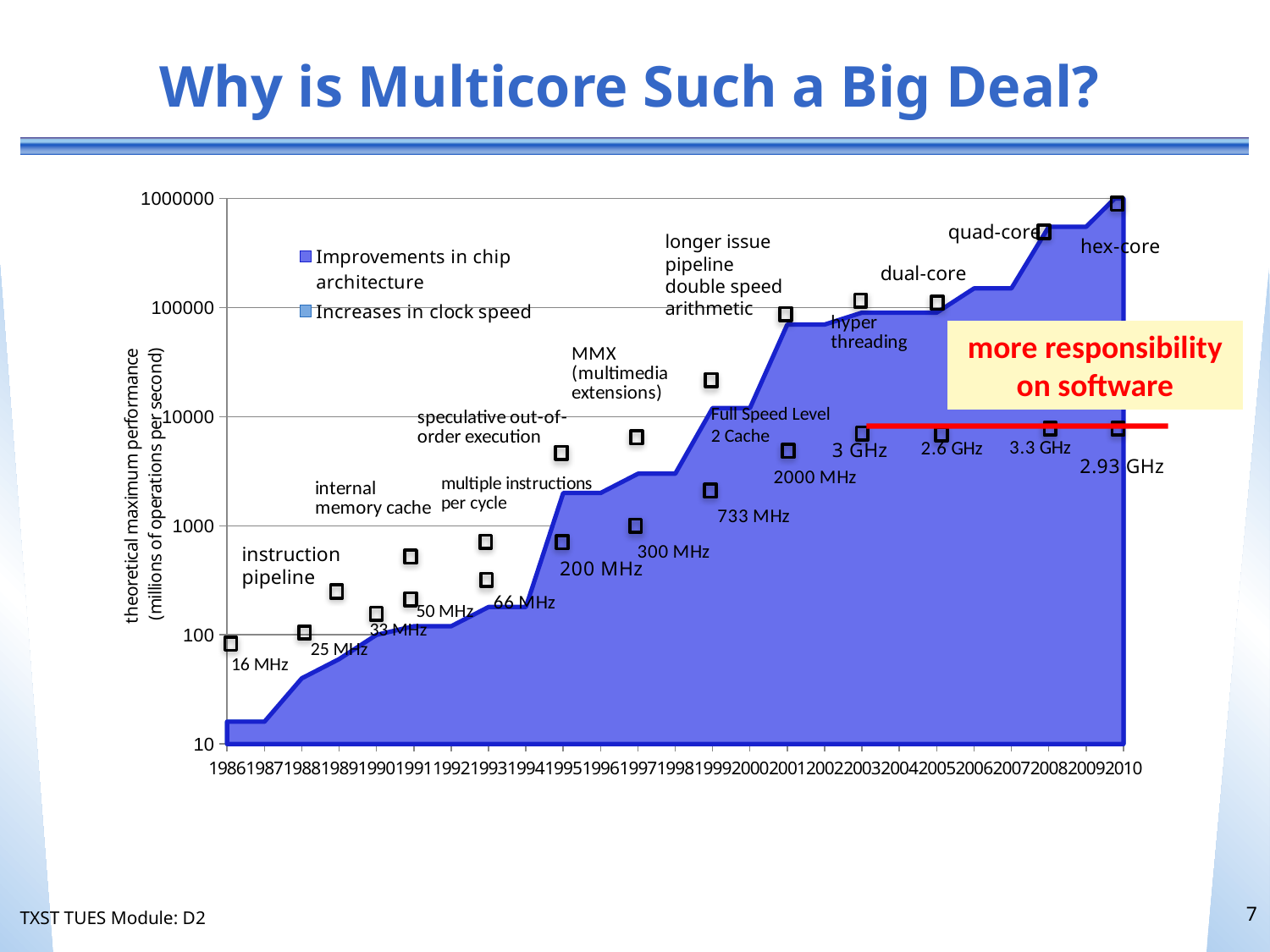
Is the value for 2010 greater or less than 100000? greater How many years are labelled along the x axis of the chart? 25 How many series does the chart legend list? 2 What kind of chart is shown on the slide? area chart Does the plotted performance rise or fall as the years increase along the x axis? rise Which is larger, the value for 2005 or the value for 1995? 2005 Is the value for 1993 greater or less than 1000? less In which year does the chart reach its highest value? 2010 In which year does the chart show its lowest value? 1986 and 1987 (tied) Is the value for 1986 greater or less than 100? less What is the label on the chart's y axis? theoretical maximum performance (millions of operations per second) What are the two series named in the chart legend? Improvements in chip architecture; Increases in clock speed